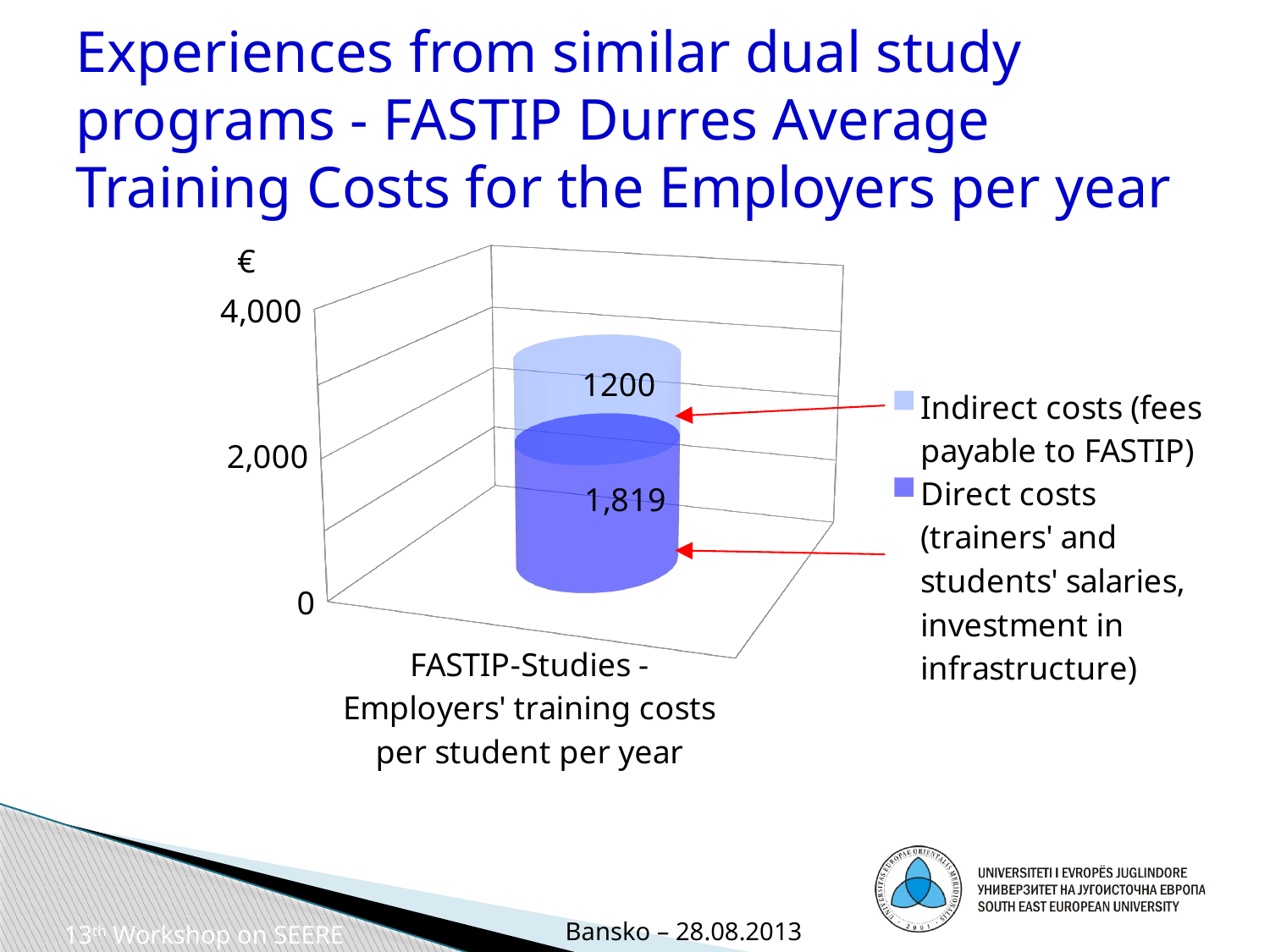
What unit is shown at the top of the vertical axis? € Which series has the larger value, Direct costs or Indirect costs? Direct costs Is the total height of the stacked bar greater or less than 2,000? greater How many series does the legend list? 2 What is the value of the Indirect costs (fees payable to FASTIP) segment in the chart? 1200 What is the value of the Direct costs segment in the chart? 1,819 What kind of chart is shown on the slide? Stacked bar chart What is the category label shown below the bar? FASTIP-Studies - Employers' training costs per student per year Is the total height of the stacked bar greater or less than 4,000? less How many categories are shown on the x axis of the chart? 1 What is the difference between the Direct costs value and the Indirect costs value? 619 What is the total of the stacked bar for FASTIP-Studies employers' training costs per student per year? 3,019